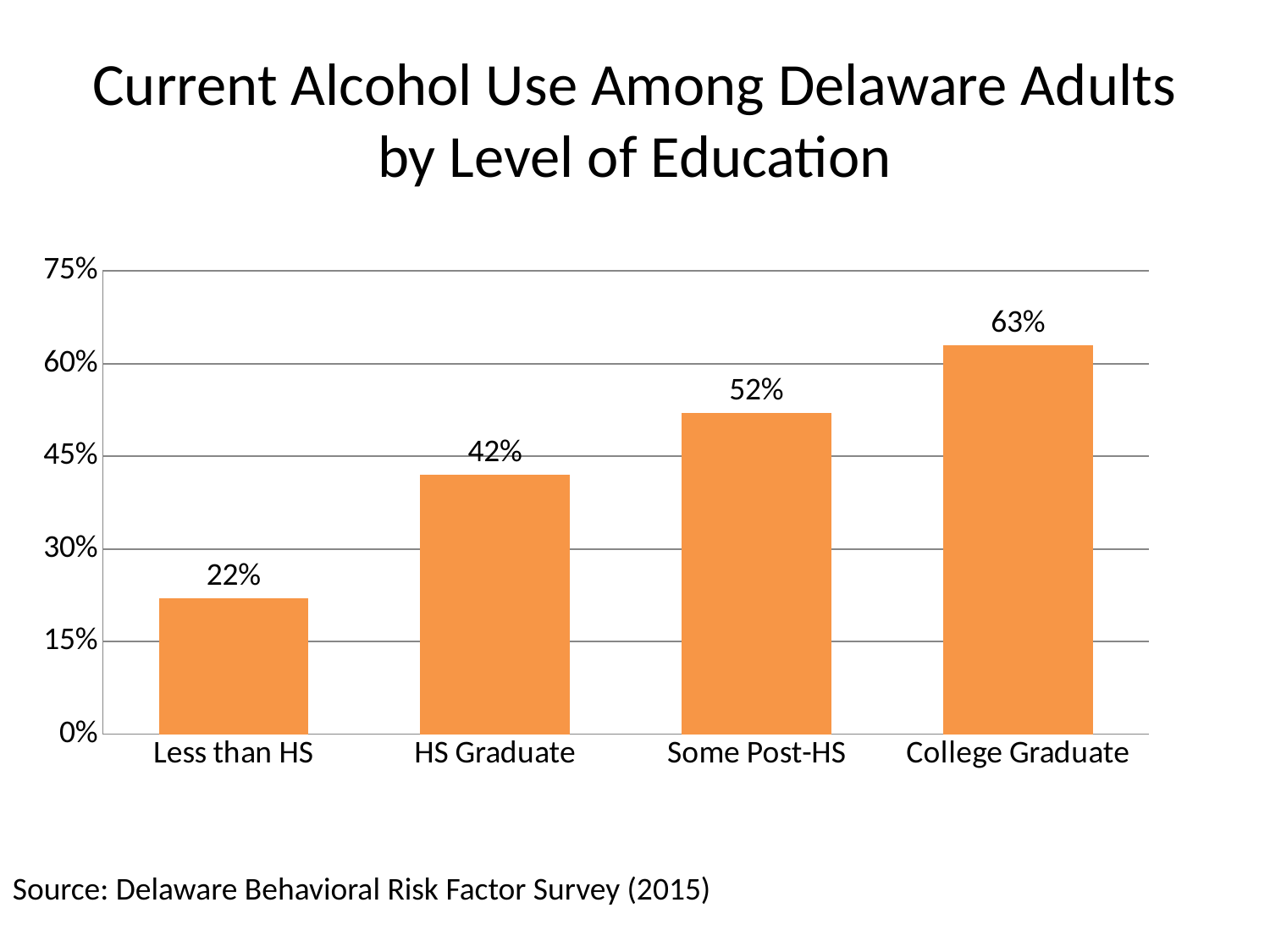
What is the value for College Graduate? 63% Which is larger, the value for HS Graduate or the value for Some Post-HS? Some Post-HS What is the difference between the values for College Graduate and Less than HS? 41% Which education level has the highest current alcohol use? College Graduate What kind of chart is shown on the slide? Bar chart What is the value for Some Post-HS? 52% What is the value for Less than HS? 22% Which education level has the lowest current alcohol use? Less than HS What is the difference between the values for Some Post-HS and HS Graduate? 10% How many education categories are shown on the chart? 4 Do the values rise or fall as education level increases from left to right? Rise What is the value for HS Graduate? 42%